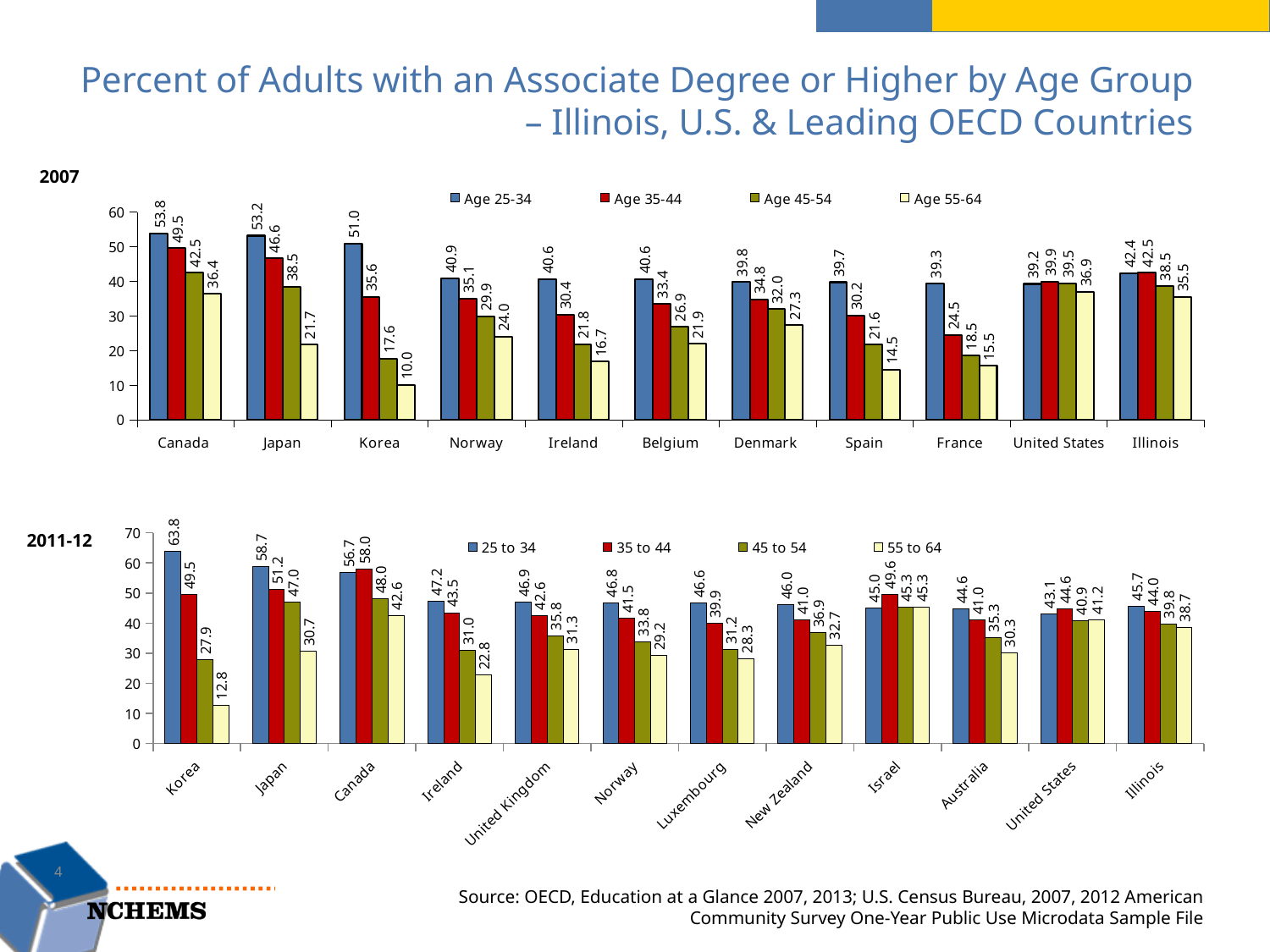
In the 2007 chart, which country has the highest value for Age 25-34? Canada In the 2011-12 chart, how many categories are shown on the x axis? 12 In the 2007 chart, what is the value for the United States in the Age 35-44 series? 39.9 In the 2007 chart, what is the value for Korea in the Age 55-64 series? 10.0 In the 2011-12 chart, what is the value for Israel in the 35 to 44 series? 49.6 In the 2011-12 chart, which category has the highest value for 25 to 34? Korea In the 2007 chart, what is the difference between the Age 25-34 and Age 55-64 values for Japan? 31.5 In the 2007 chart, which category has the lowest value for Age 55-64? Korea In the 2007 chart, how many series does the legend list? 4 In the 2011-12 chart, what is the difference between the 25 to 34 and 55 to 64 values for Korea? 51.0 What kind of chart is the 2011-12 chart? Bar chart In the 2011-12 chart, which is larger for Canada: the 25 to 34 value or the 35 to 44 value? 35 to 44